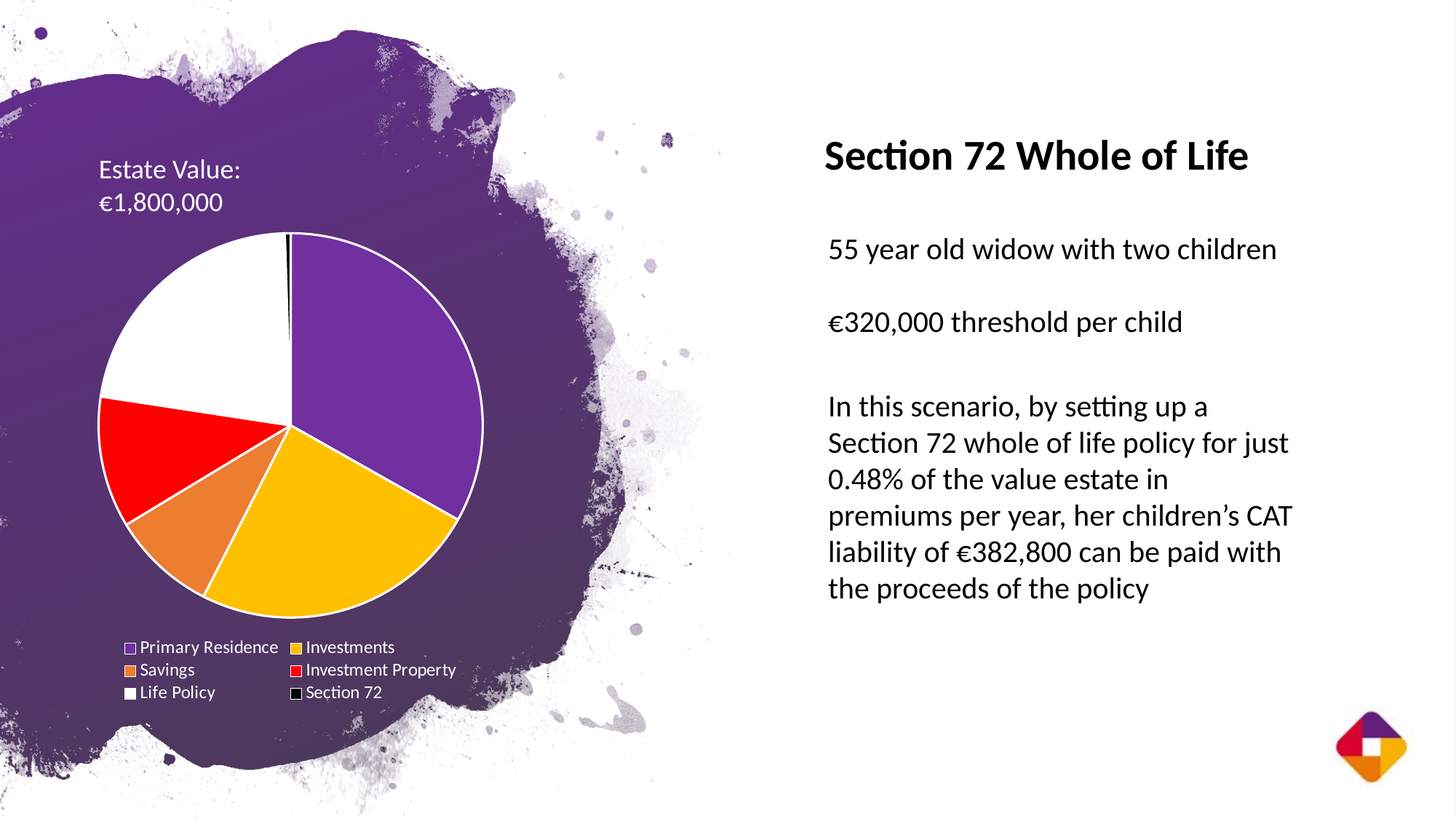
How many categories does the pie chart's legend list? 6 Which slice is larger, Primary Residence or Savings? Primary Residence Which slice is larger, Investments or Investment Property? Investments What estate value is stated above the pie chart? €1,800,000 Which slice is larger, Life Policy or Investment Property? Life Policy What colour is the Investments slice in the pie chart? yellow What kind of chart is shown on the slide? pie chart Which category has the smallest slice of the pie chart? Section 72 Which category has the largest slice of the pie chart? Primary Residence